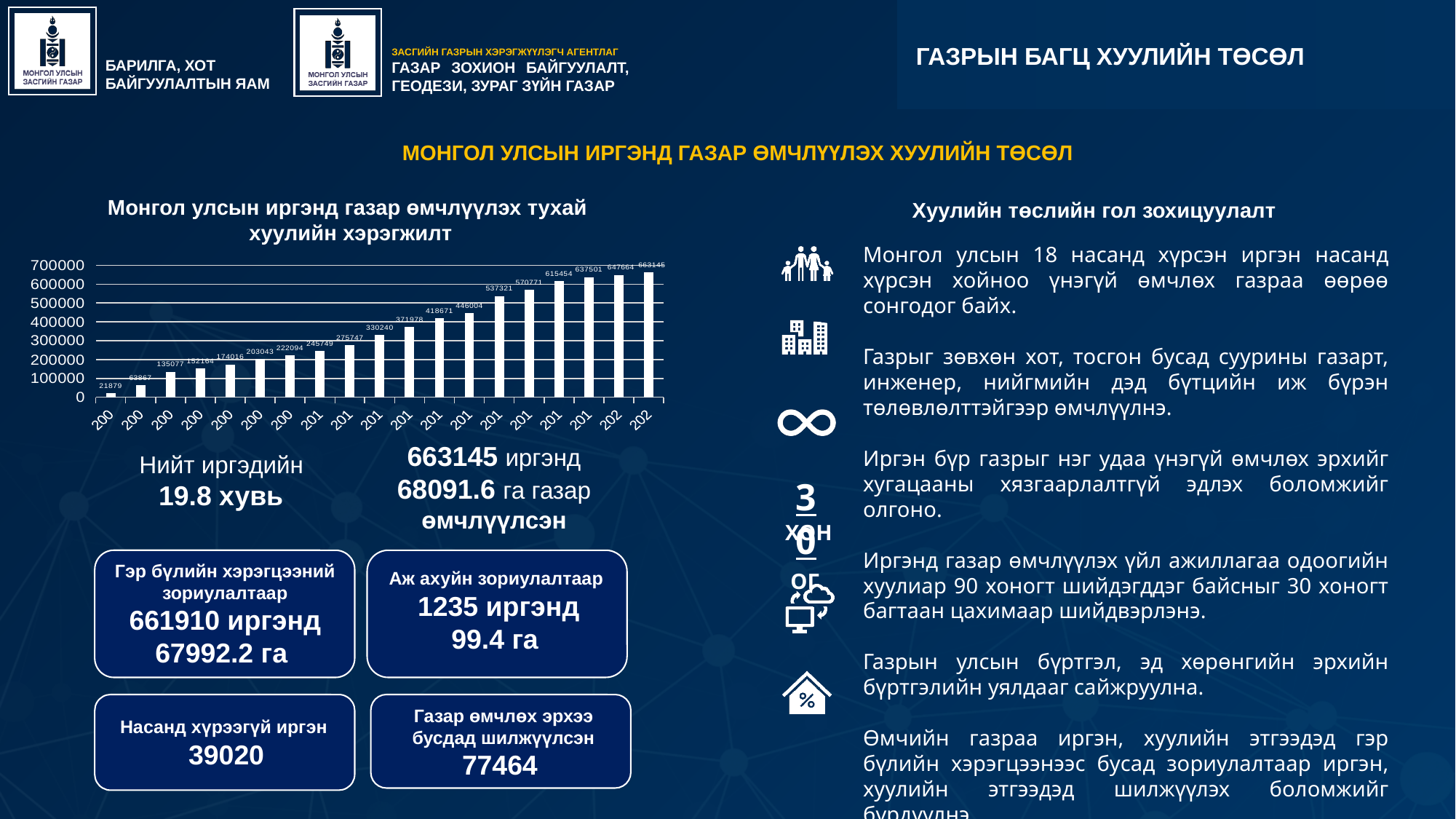
Which is larger: the bar labelled 537321 or the bar labelled 446004? 537321 Is the value of the rightmost bar greater or less than 600000? greater Do the bar values generally rise or fall from left to right along the x axis? Rise What is the data label on the first (leftmost) bar of the chart? 21879 What is the value of the shortest bar in the chart? 21879 What is the value of the tallest bar in the chart? 663145 What is the data label on the last (rightmost) bar of the chart? 663145 What kind of chart is shown under the title "Монгол улсын иргэнд газар өмчлүүлэх тухай хуулийн хэрэгжилт"? Bar chart How many bars are plotted in the chart? 19 What is the highest value shown on the chart's vertical axis? 700000 What is the difference between the last bar (663145) and the first bar (21879) in the chart? 641266 What is the data label on the second bar from the left in the chart? 63867